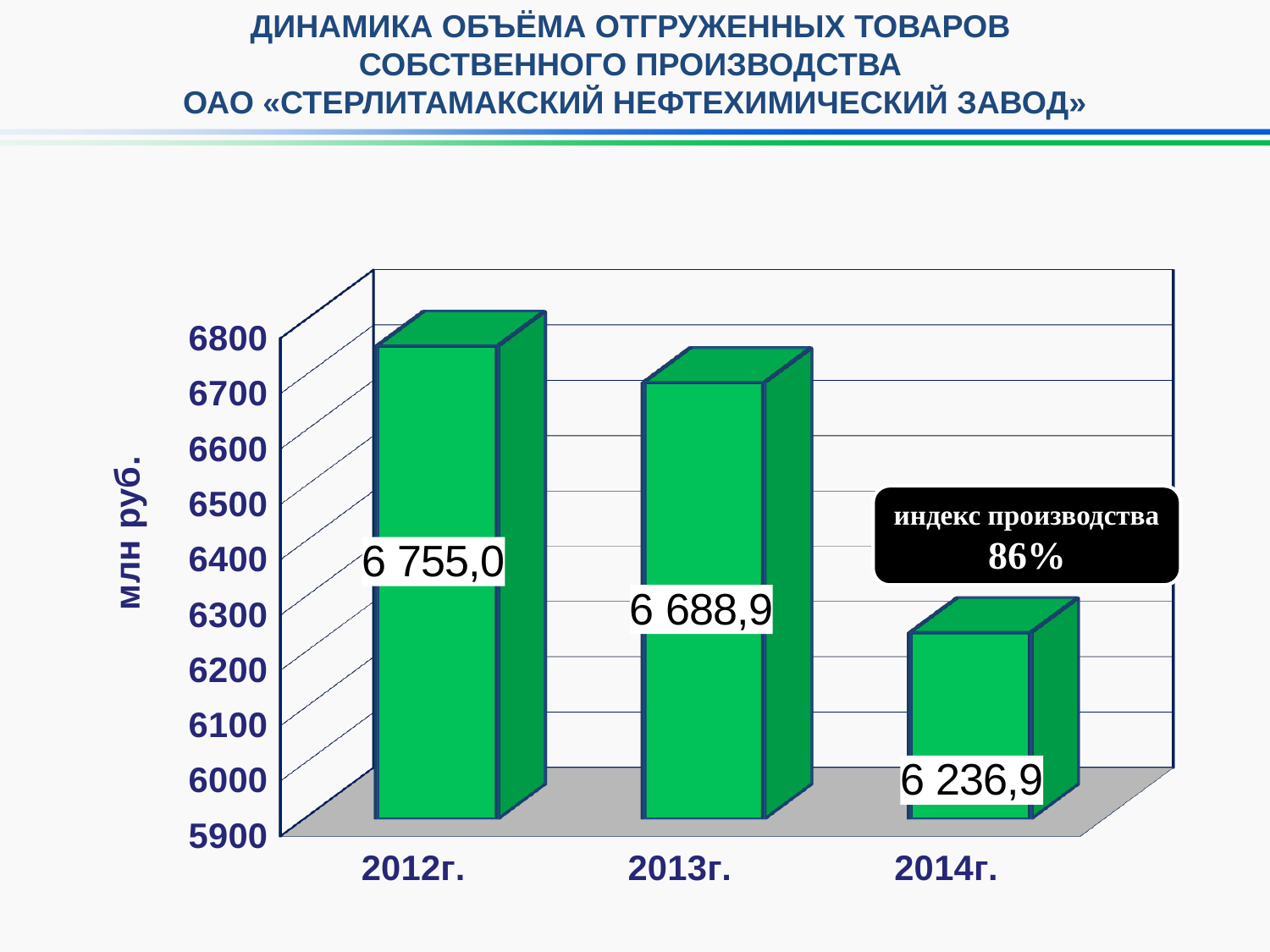
What is the value for 2013г.? 6 688,9 Which year has the lowest value? 2014г. What is the value for 2014г.? 6 236,9 What is the value for 2012г.? 6 755,0 What kind of chart is shown on the slide? bar chart Which year has the highest value? 2012г. Is the value for 2014г. greater or less than 6300? less What is the difference between the values for 2013г. and 2014г.? 452,0 Do the values rise or fall from 2012г. to 2014г.? fall Which is larger, the value for 2012г. or the value for 2014г.? 2012г. How many years are shown on the chart? 3 What is the difference between the values for 2012г. and 2013г.? 66,1